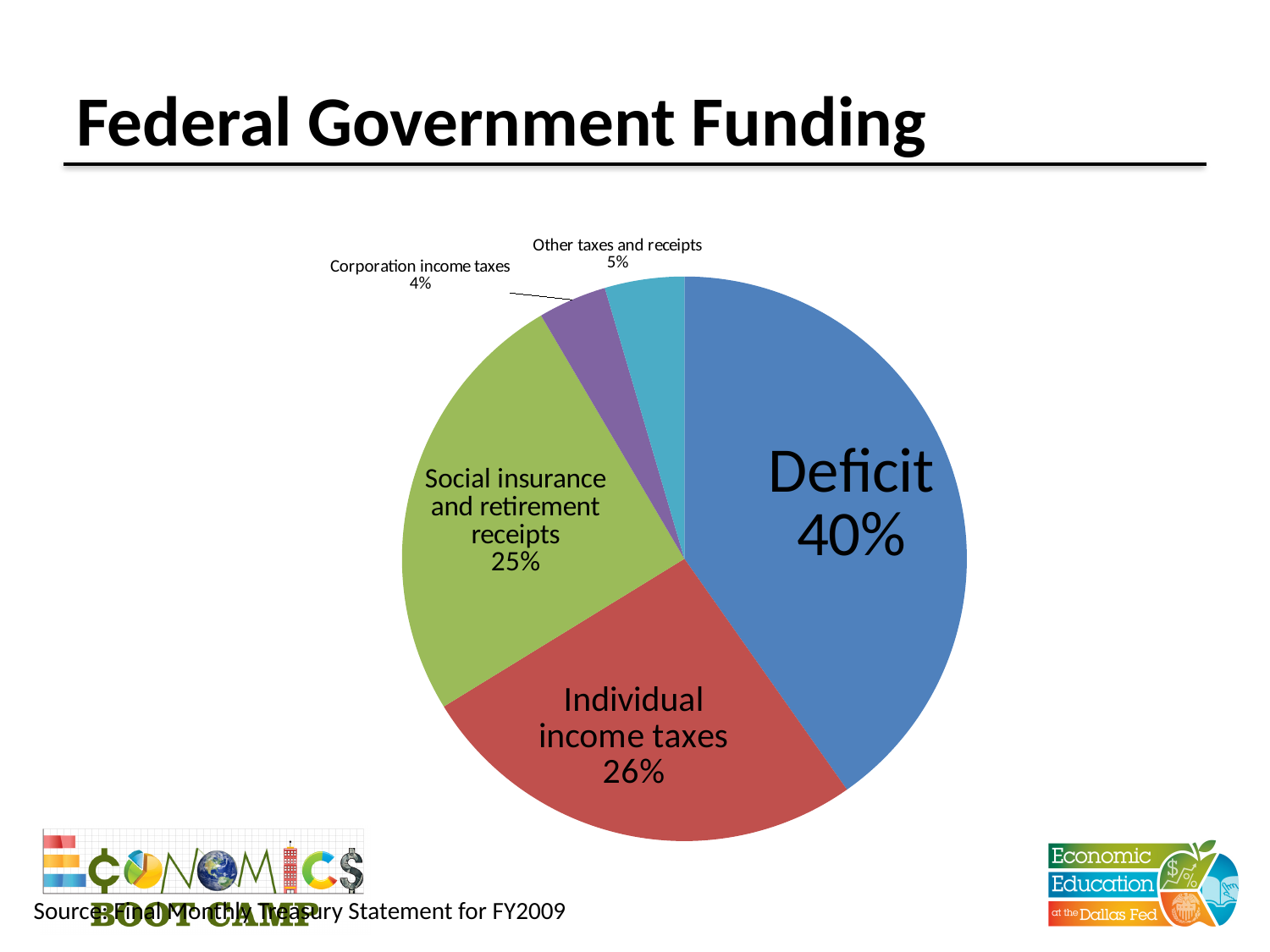
What percentage is shown for Other taxes and receipts? 5% What percentage is shown for Corporation income taxes? 4% What is the difference in percentage points between Deficit and Individual income taxes? 14 What type of chart is shown on the slide? Pie chart Which is larger, Other taxes and receipts or Corporation income taxes? Other taxes and receipts Which slice of the pie is the smallest? Corporation income taxes What share of the pie does Deficit represent? 40% What is the title of the slide? Federal Government Funding What percentage is shown for Individual income taxes? 26% What percentage is shown for Social insurance and retirement receipts? 25% Which slice of the pie is the largest? Deficit How many slices does the pie chart have? 5